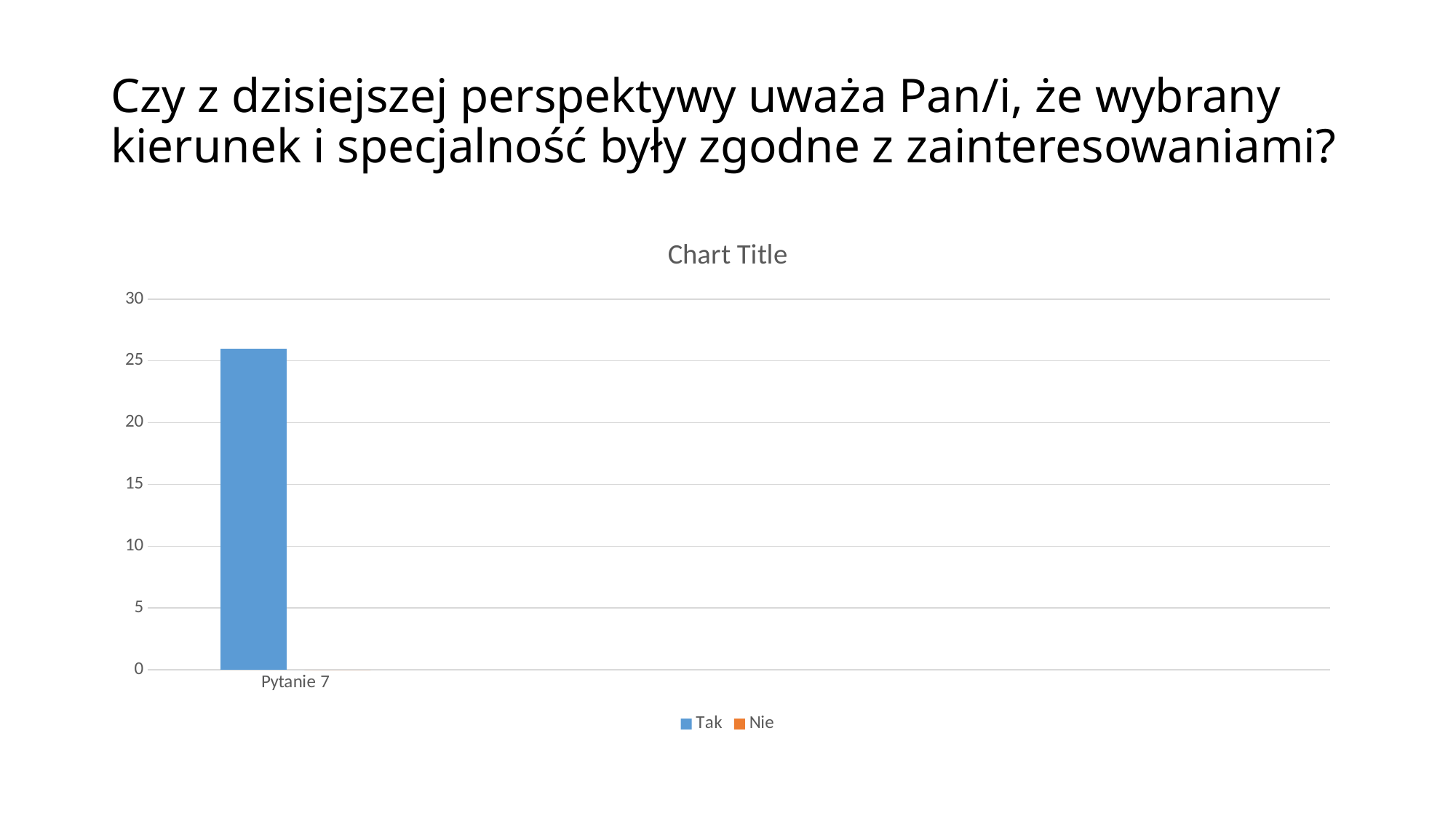
Is the value for Nie greater or less than 5? less Which series has the lowest value for Pytanie 7? Nie How many categories are shown on the x axis? 1 Which series has the highest value for Pytanie 7? Tak What is the title shown above the chart? Chart Title Which is larger for Pytanie 7, Tak or Nie? Tak How many series does the legend list? 2 Is the value for Tak greater or less than 30? less What kind of chart is shown on the slide? bar chart What colour is the bar for the Tak series? blue Is the value for Tak greater or less than 25? greater